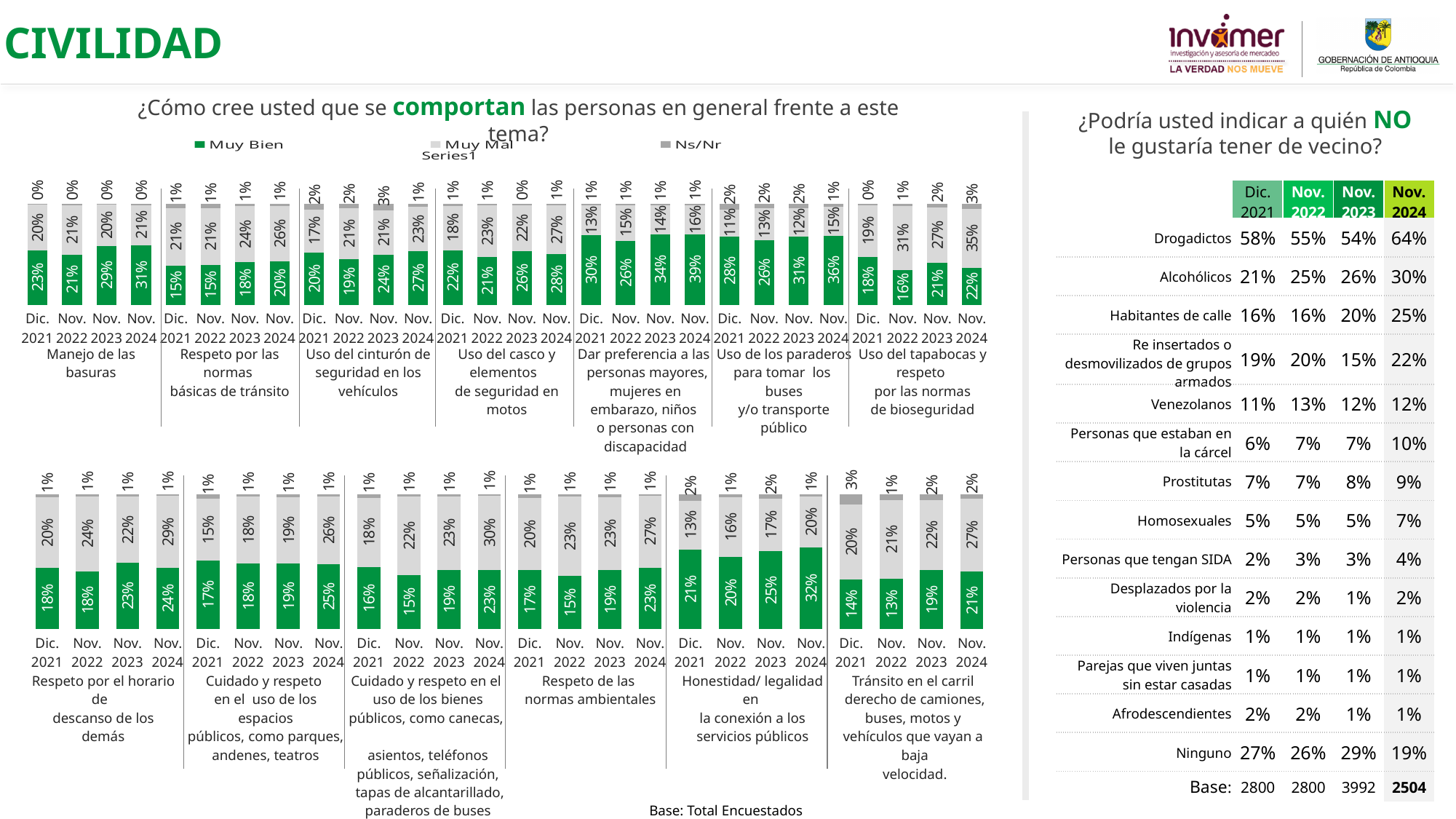
In the bottom chart, which topic has the lowest Muy Bien value in Dic. 2021? Tránsito en el carril derecho de camiones, buses, motos y vehículos que vayan a baja velocidad In the bottom chart, how does the Muy Bien value for Respeto por el horario de descanso de los demás change from Nov. 2022 to Nov. 2024? It rises In the bottom chart, what is the Muy Bien value for Honestidad/ legalidad en la conexión a los servicios públicos in Nov. 2024? 32% In the top chart, which topic has the highest Muy Bien value in Nov. 2024? Dar preferencia a las personas mayores, mujeres en embarazo, niños o personas con discapacidad In the bottom chart, is the Muy Mal value for Cuidado y respeto en el uso de los bienes públicos in Nov. 2024 larger or smaller than its Muy Bien value? larger In the top chart, what is the Muy Mal value for Uso del tapabocas y respeto por las normas de bioseguridad in Nov. 2024? 35% In the top chart, what is the Muy Bien value for Manejo de las basuras in Nov. 2024? 31% In the top chart, what is the difference between the Muy Bien values for Dar preferencia a las personas mayores in Nov. 2024 and Dic. 2021? 9% What type of chart is used for the top chart? Stacked bar chart In the top chart, what is the total of the stacked bar for Uso del cinturón de seguridad en los vehículos in Nov. 2023? 48% In the bottom chart, how many topics (category groups) are shown? 6 In the top chart, how many series does the legend list? 4